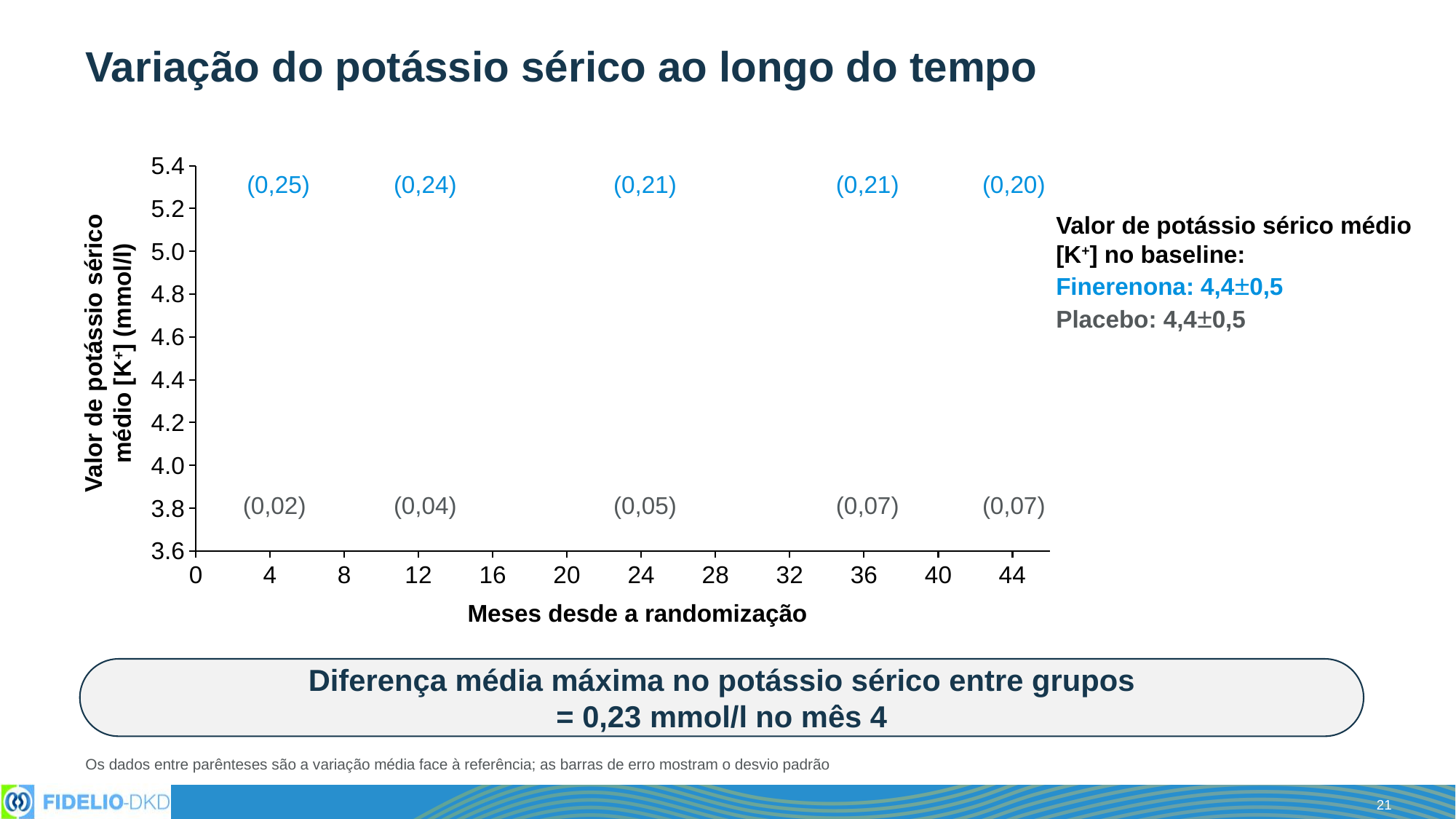
What is the title of the chart? Variação do potássio sérico ao longo do tempo Do the blue (finerenona) change-from-baseline values rise or fall from month 4 to month 44? fall What is the mean change from baseline printed in blue (finerenona) at month 4? 0,25 What is the mean change from baseline printed in grey (placebo) at month 44? 0,07 How many time points have change-from-baseline values printed on the chart? 5 At month 24, which printed change-from-baseline value is larger, the blue (finerenona) or the grey (placebo)? blue (finerenona) What is the mean change from baseline printed in grey (placebo) at month 24? 0,05 What is the mean change from baseline printed in grey (placebo) at month 4? 0,02 What is the mean change from baseline printed in blue (finerenona) at month 44? 0,20 What is the label of the x axis of the chart? Meses desde a randomização Do the grey (placebo) change-from-baseline values rise or fall from month 4 to month 44? rise What is the difference between the blue (finerenona) and grey (placebo) change-from-baseline values at month 4? 0,23